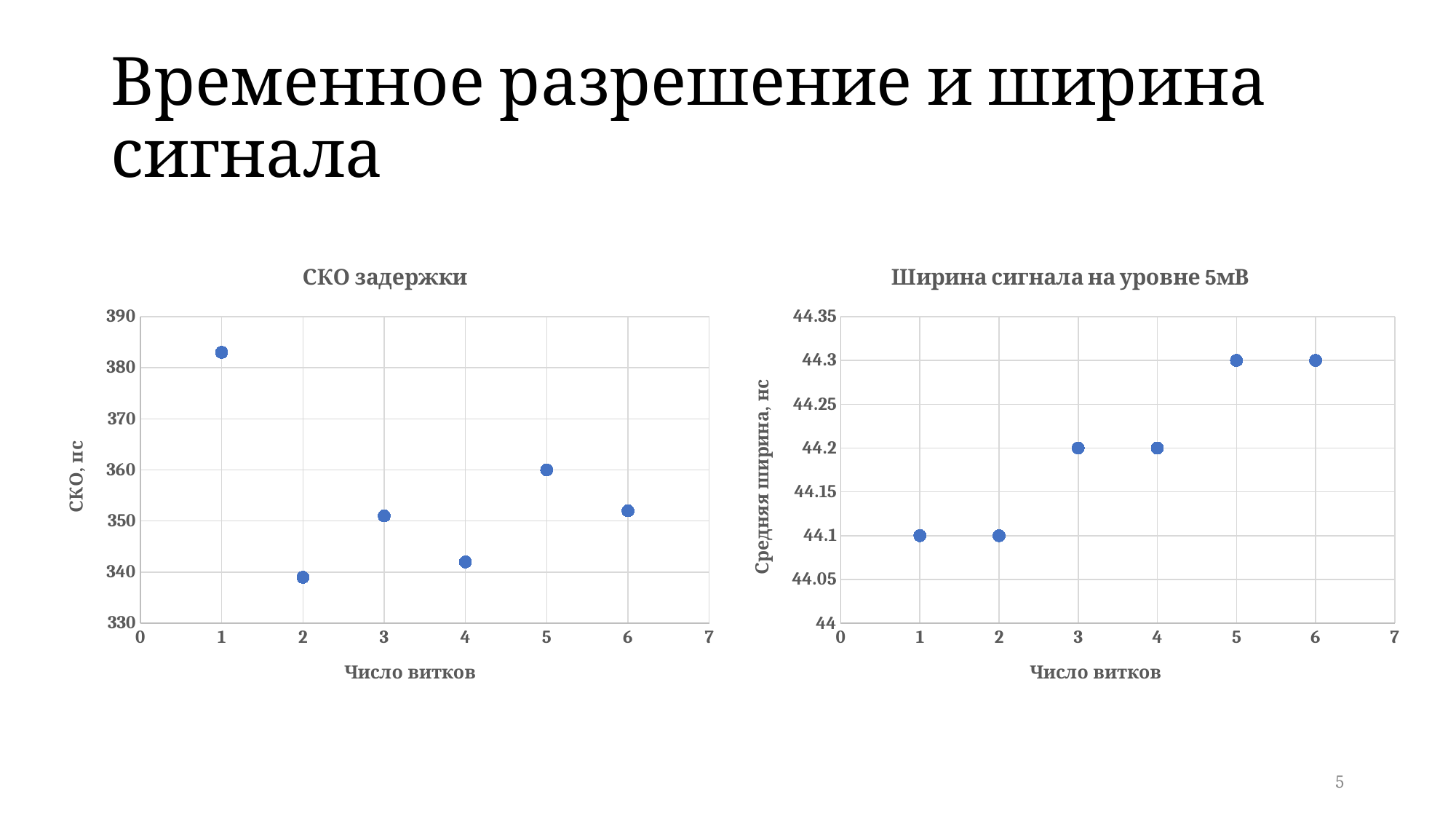
In the "СКО задержки" chart, at which number of turns (Число витков) is the СКО highest? 1 In the "Ширина сигнала на уровне 5мВ" chart, do the values rise or fall as the number of turns increases? rise What kind of chart is the "СКО задержки" chart on the left? scatter chart In the "Ширина сигнала на уровне 5мВ" chart, what is the average width at 3 turns? 44.2 In the "Ширина сигнала на уровне 5мВ" chart, what is the average width at 6 turns? 44.3 In the "Ширина сигнала на уровне 5мВ" chart, what is the average width at 1 turn? 44.1 In the "Ширина сигнала на уровне 5мВ" chart, what is the difference between the value at 5 turns and the value at 2 turns? 0.2 What is the y-axis label of the "Ширина сигнала на уровне 5мВ" chart? Средняя ширина, нс In the "СКО задержки" chart, is the value at 1 turn greater or less than 380? greater In the "СКО задержки" chart, how many data points are plotted? 6